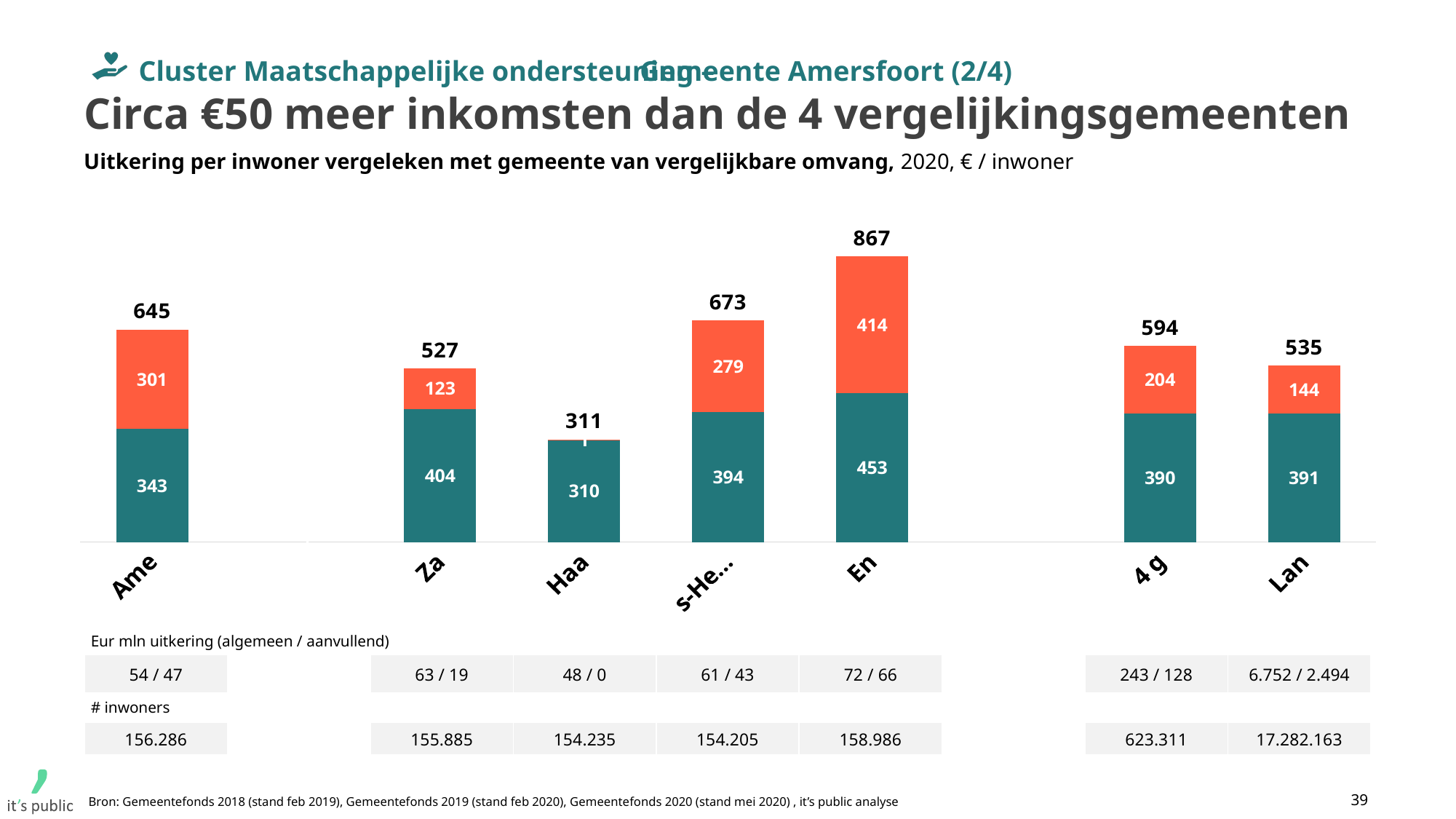
What is the total value shown above the bar for Ame? 645 What is the subtitle of the chart, as printed above it? Uitkering per inwoner vergeleken met gemeente van vergelijkbare omvang, 2020, € / inwoner Which has a larger total value, Za or 4 g? 4 g Which category has the lowest total value? Haa Which category has the highest total value? En What is the value of the orange (top) segment of the bar for Za? 123 What is the total value shown above the bar for Lan? 535 What kind of chart is shown on the slide? Stacked bar chart What is the value of the teal (bottom) segment of the bar for En? 453 How many categories (bars) are shown in the chart? 7 What is the difference between the total for Ame and the total for 4 g? 51 What is the difference between the total for En and the total for s-He...? 194